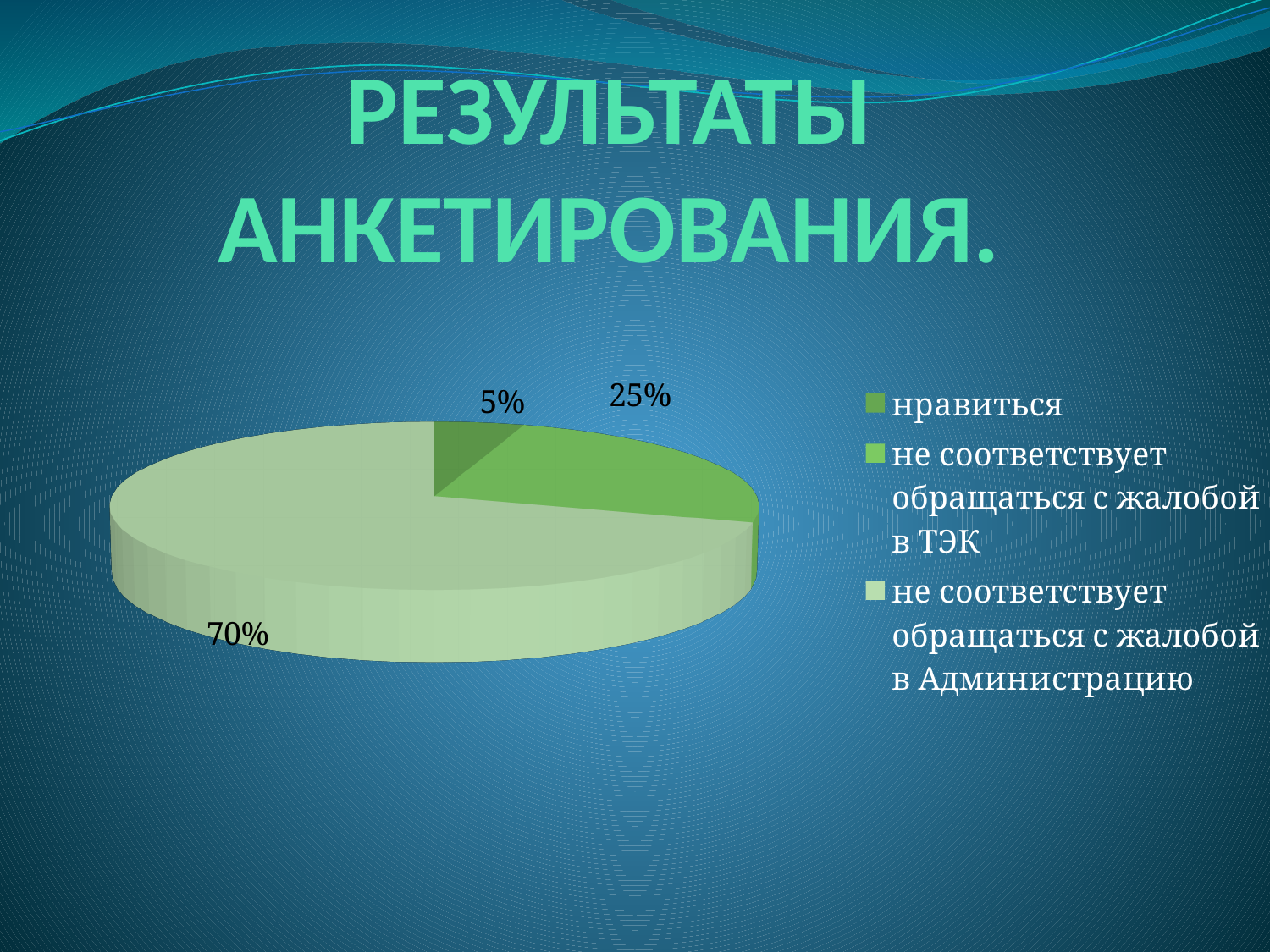
What is the title of the slide containing the chart? РЕЗУЛЬТАТЫ АНКЕТИРОВАНИЯ. What is the difference between the share for "не соответствует обращаться с жалобой в ТЭК" and the share for "нравиться"? 20% How many slices does the pie chart have? 3 What share of the pie does "нравиться" have? 5% What kind of chart is shown on the slide? pie chart Which category has the smallest slice of the pie? нравиться How many entries does the legend list? 3 What is the difference between the share for "не соответствует обращаться с жалобой в Администрацию" and the share for "не соответствует обращаться с жалобой в ТЭК"? 45% Which is larger: the share for "нравиться" or the share for "не соответствует обращаться с жалобой в ТЭК"? не соответствует обращаться с жалобой в ТЭК What share of the pie does "не соответствует обращаться с жалобой в Администрацию" have? 70% Which category has the largest slice of the pie? не соответствует обращаться с жалобой в Администрацию What share of the pie does "не соответствует обращаться с жалобой в ТЭК" have? 25%